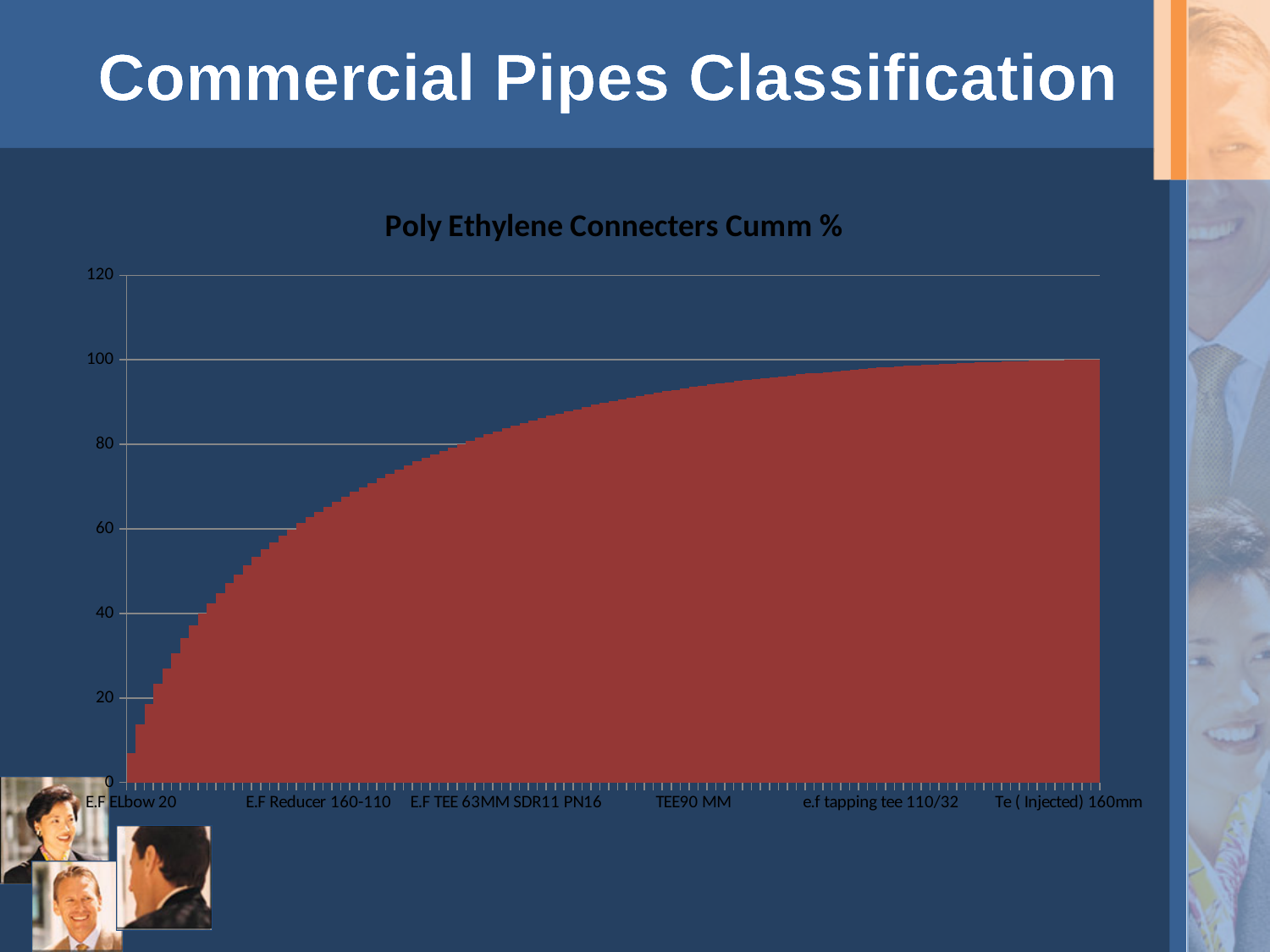
Which is larger, the value for E.F ELbow 20 or the value for TEE90 MM? TEE90 MM Which labelled category has the highest cumulative value? Te ( Injected) 160mm Do the values rise or fall moving left to right along the x axis? rise What is the title of the chart? Poly Ethylene Connecters Cumm % Is the value for E.F TEE 63MM SDR11 PN16 greater or less than 60? greater Is the value for TEE90 MM greater or less than 80? greater Is the value for E.F ELbow 20 greater or less than 20? less What is the highest value shown on the y axis? 120 Which labelled category has the lowest cumulative value? E.F ELbow 20 What kind of chart is shown on the slide? bar chart